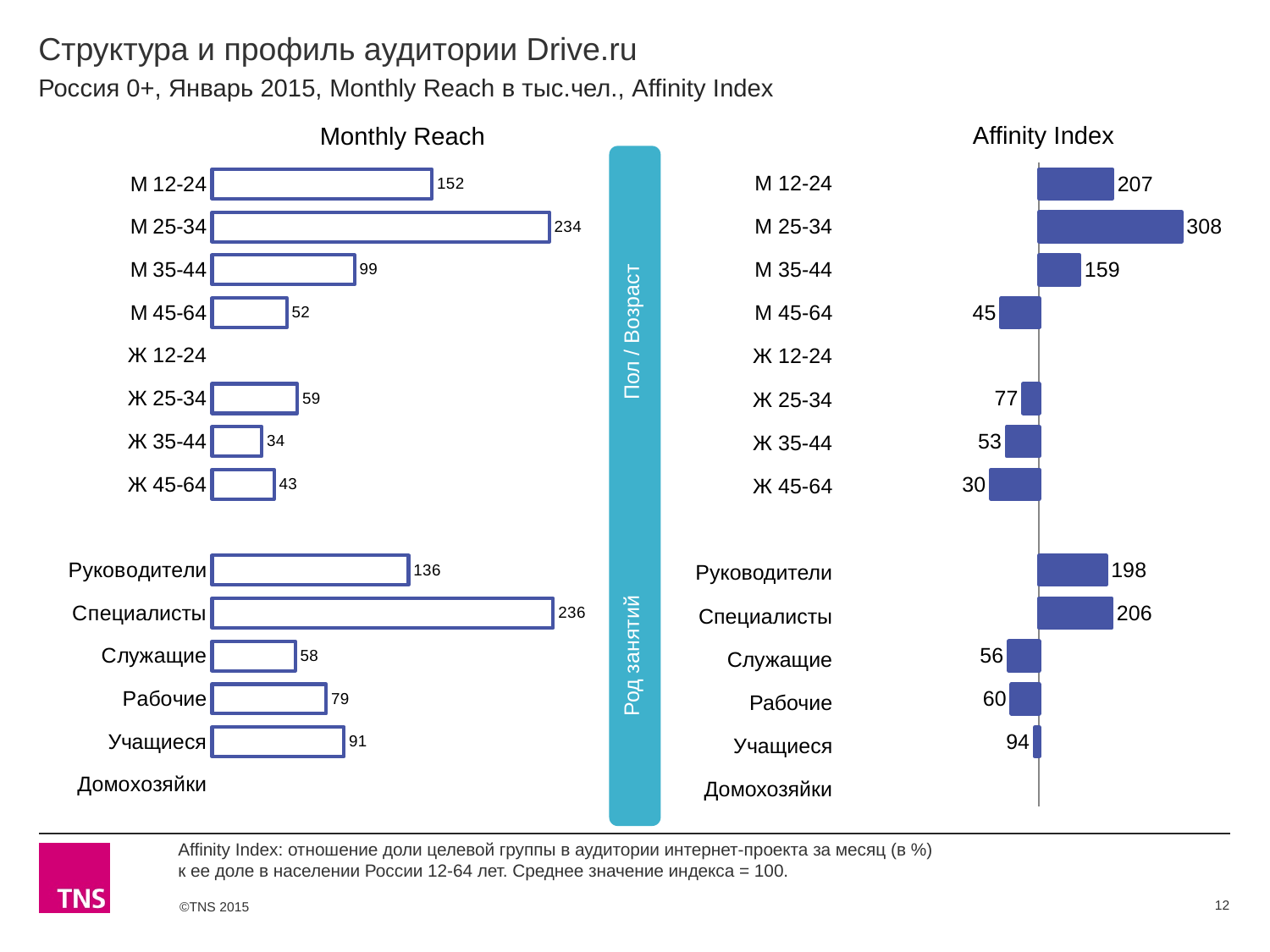
In the Affinity Index chart, what is the value for Ж 45-64? 30 In the Affinity Index chart, what is the difference between the values for Специалисты and Служащие? 150 What is the title of the chart on the right side of the slide? Affinity Index In the Monthly Reach chart, what is the value for М 25-34? 234 In the Monthly Reach chart, which category has the highest value? Специалисты In the Monthly Reach chart, what is the difference between the values for М 12-24 and М 35-44? 53 In the Affinity Index chart, which is larger: the value for М 45-64 or the value for Ж 25-34? Ж 25-34 In the Monthly Reach chart, which is larger: the value for Рабочие or the value for Учащиеся? Учащиеся In the Affinity Index chart, what is the value for Руководители? 198 In the Affinity Index chart, which category has the highest value? М 25-34 What kind of chart is the Monthly Reach chart? Bar chart In the Monthly Reach chart, which labelled category has the lowest value? Ж 35-44